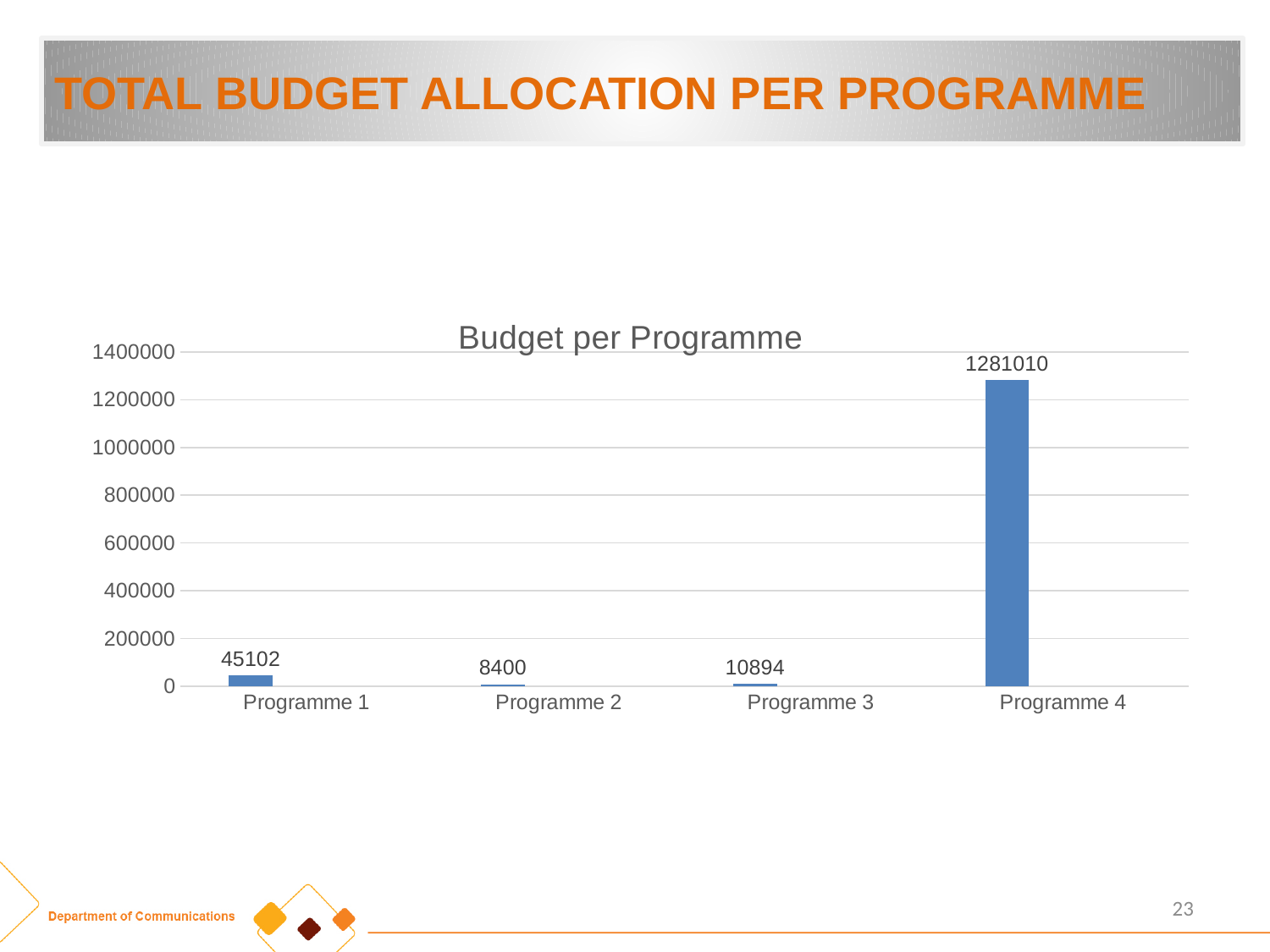
What is the value for Programme 2? 8400 What is the value for Programme 3? 10894 Which programme has the lowest budget? Programme 2 Which programme has the highest budget? Programme 4 What is the difference between the values for Programme 3 and Programme 2? 2494 Is the value for Programme 4 greater or less than 1200000? greater What is the value for Programme 4? 1281010 What is the value for Programme 1? 45102 What is the difference between the values for Programme 4 and Programme 1? 1235908 Which is larger, the value for Programme 1 or Programme 3? Programme 1 What type of chart is shown? bar chart How many programmes are shown on the chart? 4